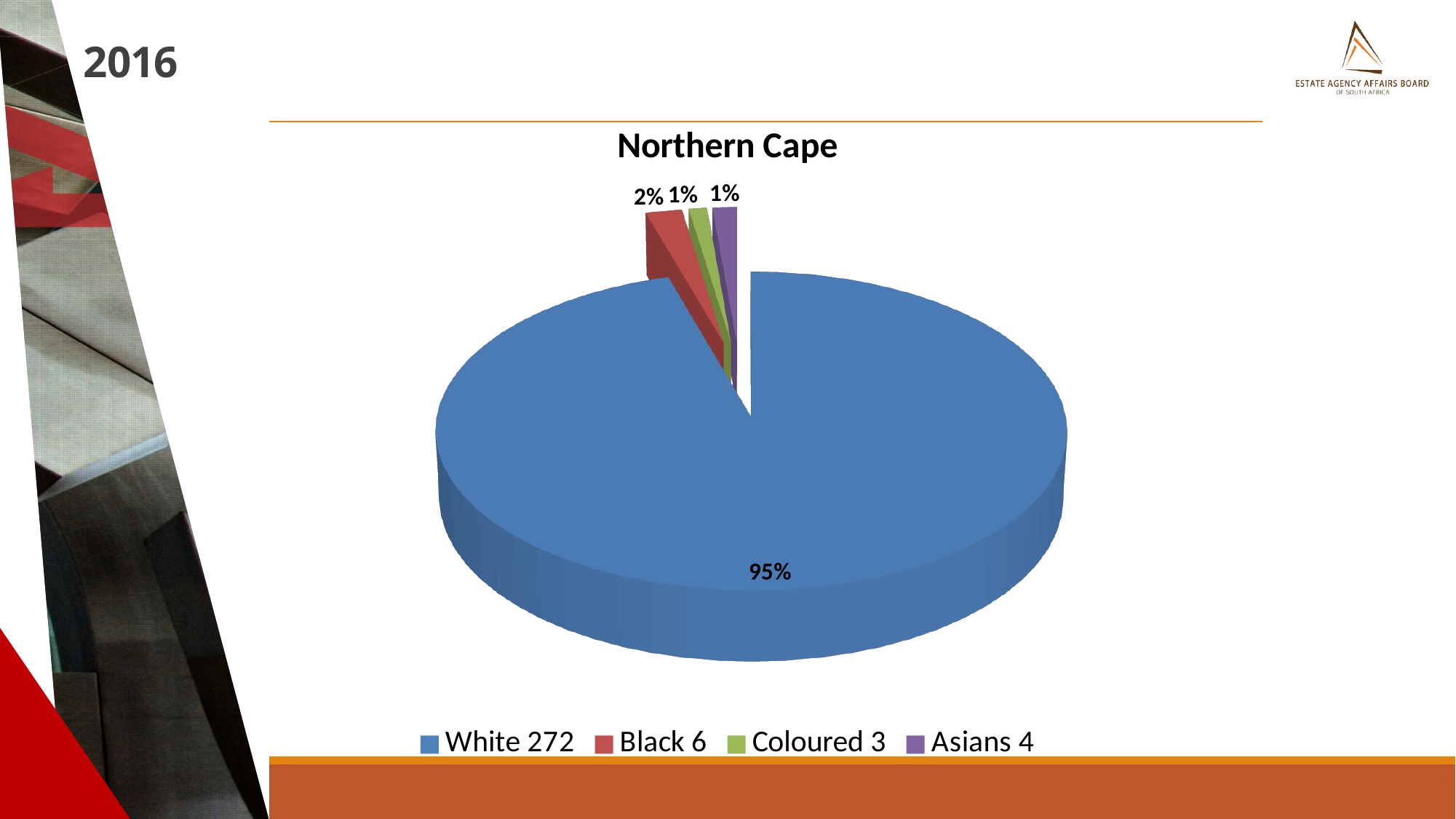
What is the difference in percentage points between the White slice and the Black slice? 93% What count is shown for White in the legend? 272 Which category has the largest slice of the pie? White What count is shown for Asians in the legend? 4 What share of the pie does the Black slice represent? 2% What share of the pie does the Coloured slice represent? 1% What type of chart is shown on the slide? pie chart Which slice is larger, Black or Asians? Black What is the title of the chart? Northern Cape What share of the pie does the White slice represent? 95% How many categories does the pie chart have? 4 Which category has the smallest count according to the legend? Coloured